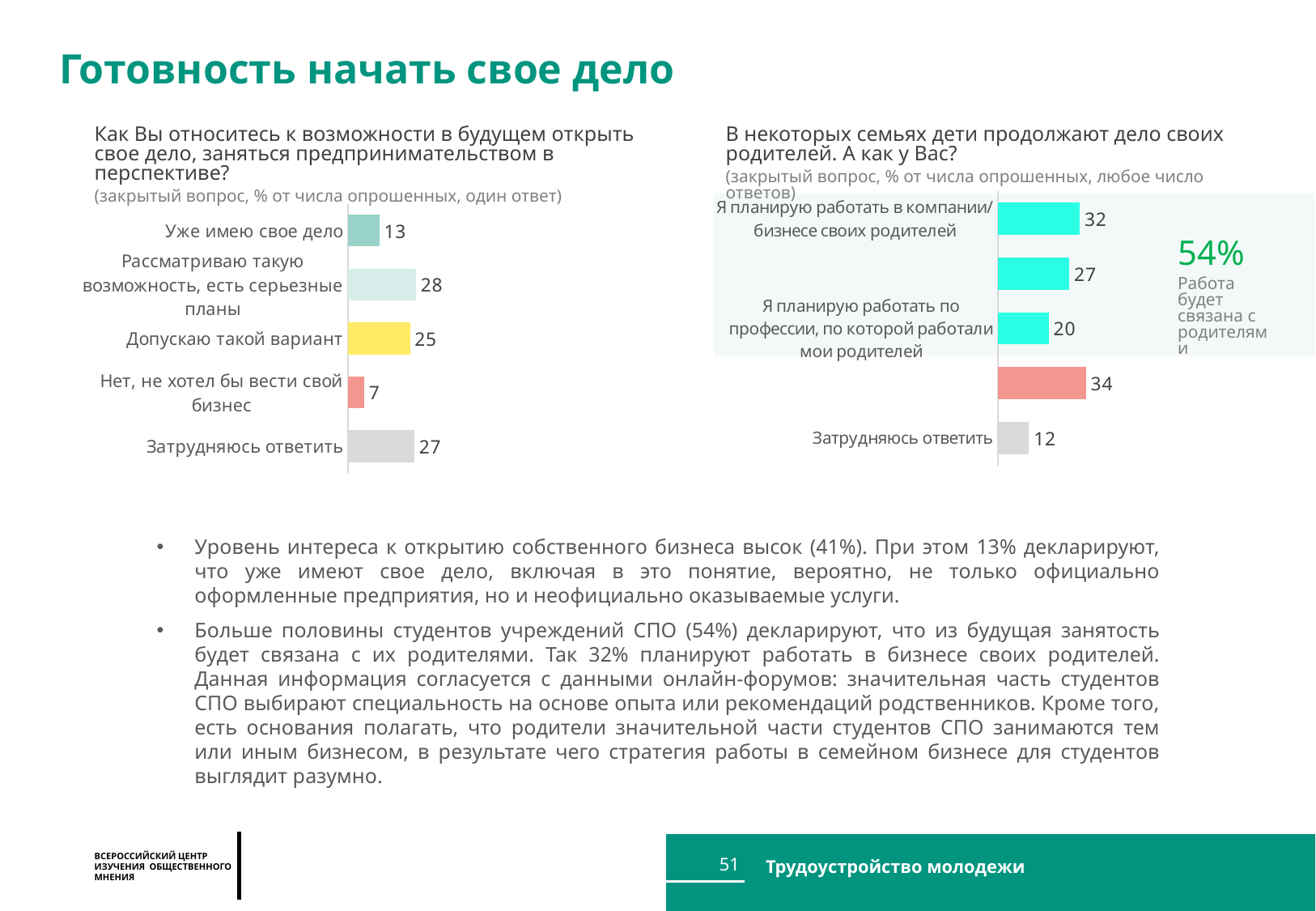
On the right chart, what is the value for "Я планирую работать по профессии, по которой работали мои родителей"? 20 On the left chart, what is the value for "Допускаю такой вариант"? 25 On the right chart, what is the value for "Затрудняюсь ответить"? 12 On the right chart, what is the difference between "Я планирую работать в компании/бизнесе своих родителей" and "Затрудняюсь ответить"? 20 On the left chart, which is larger: "Затрудняюсь ответить" or "Допускаю такой вариант"? Затрудняюсь ответить On the left chart, which category has the lowest value? Нет, не хотел бы вести свой бизнес On the left chart, what is the value for "Уже имею свое дело"? 13 What type of chart is the left chart? Bar chart How many categories are shown on the left chart? 5 On the left chart, what is the difference between "Рассматриваю такую возможность, есть серьезные планы" and "Нет, не хотел бы вести свой бизнес"? 21 On the right chart, what is the value for "Я планирую работать в компании/бизнесе своих родителей"? 32 On the left chart, which category has the highest value? Рассматриваю такую возможность, есть серьезные планы